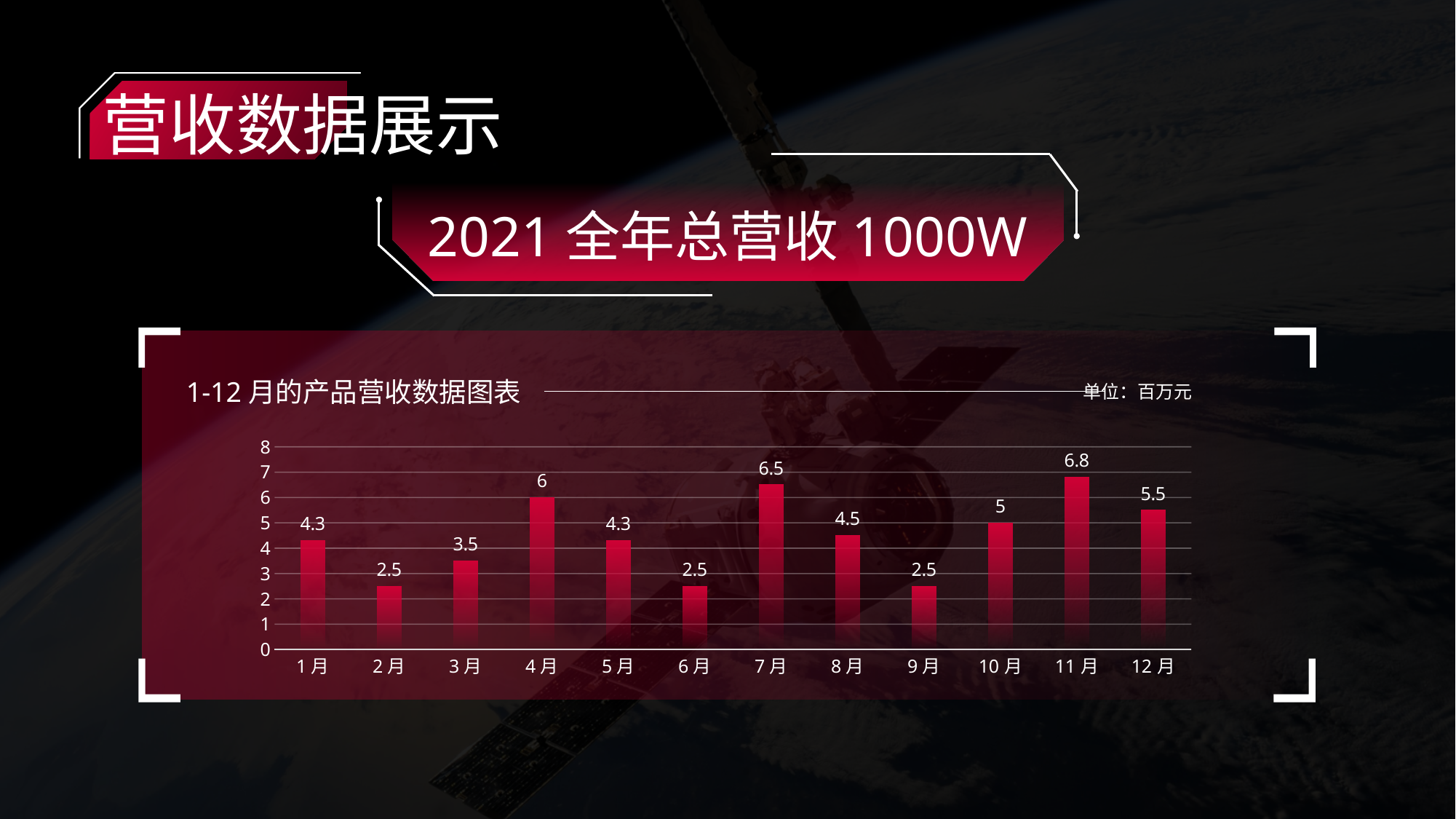
What is the title of the chart? 1-12 月的产品营收数据图表 Which month has the highest value? 11月 Do the values rise or fall from 9月 to 11月? rise What is the difference between the values for 7月 and 6月? 4 What is the value for 8月? 4.5 What unit is stated for the chart values? 百万元 Is the value for 12月 greater or less than 5? greater How many months are shown on the x axis? 12 What is the value for 11月? 6.8 Which is larger, the value for 3月 or the value for 5月? 5月 What kind of chart is shown on the slide? bar chart What is the value for 4月? 6